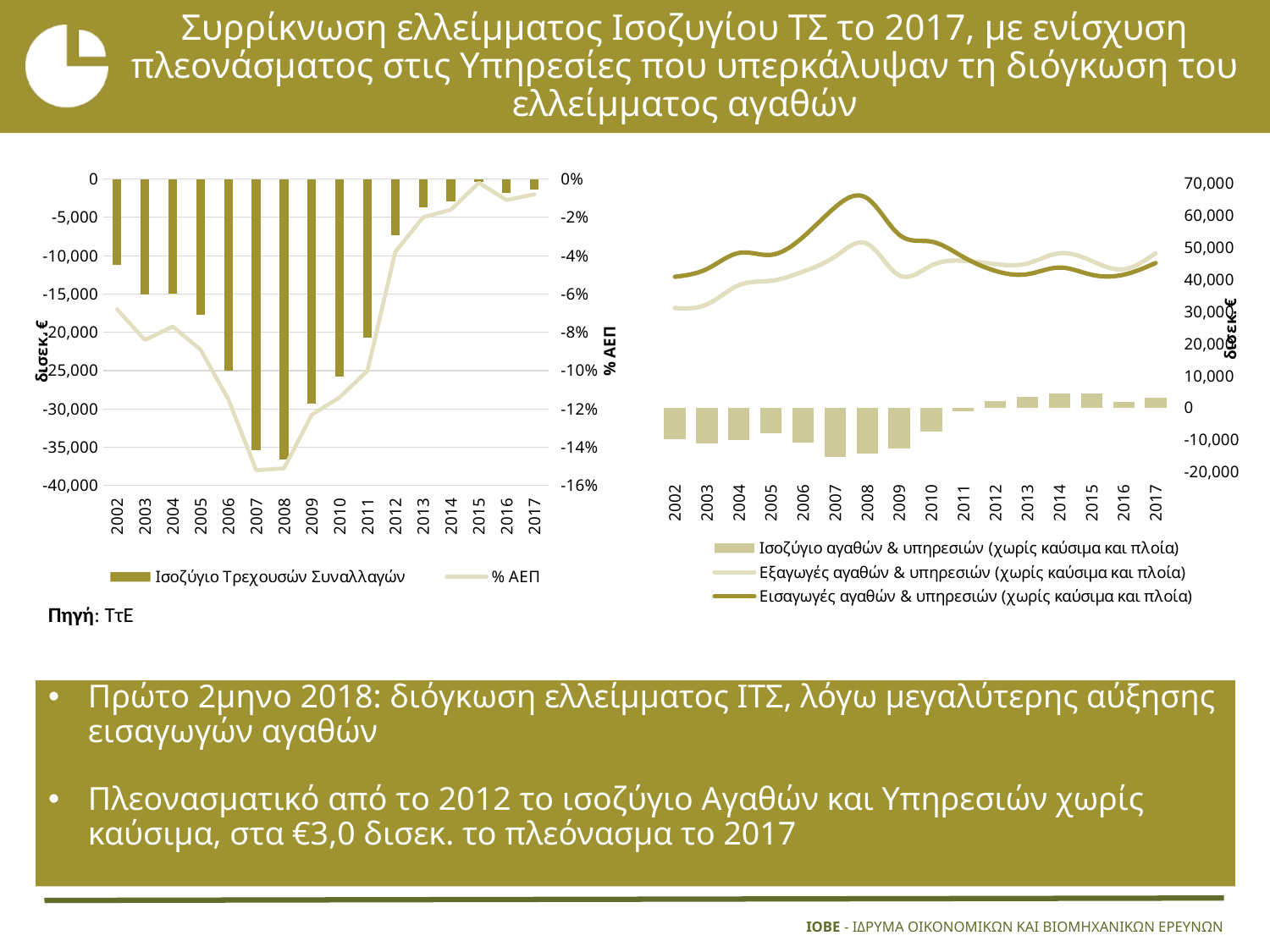
What kind of chart is the left chart (Ισοζύγιο Τρεχουσών Συναλλαγών)? Combined bar and line chart In the right chart, does the Εισαγωγές αγαθών & υπηρεσιών line rise or fall from 2002 to 2008? rise In the right chart, is the Εισαγωγές αγαθών & υπηρεσιών line for 2008 greater or less than 60,000? greater In the right chart, which is larger in 2008, Εισαγωγές or Εξαγωγές αγαθών & υπηρεσιών? Εισαγωγές In the left chart, is the Ισοζύγιο Τρεχουσών Συναλλαγών bar for 2010 greater or less than -20,000? less In the left chart, which year has the Ισοζύγιο Τρεχουσών Συναλλαγών bar closest to zero? 2015 How many series does the legend of the right chart list? 3 In the right chart, is the Ισοζύγιο αγαθών & υπηρεσιών bar for 2008 greater or less than -10,000? less In the left chart, which is larger, the Ισοζύγιο Τρεχουσών Συναλλαγών value for 2007 or for 2012? 2012 How many years are shown on the x axis of the left chart? 16